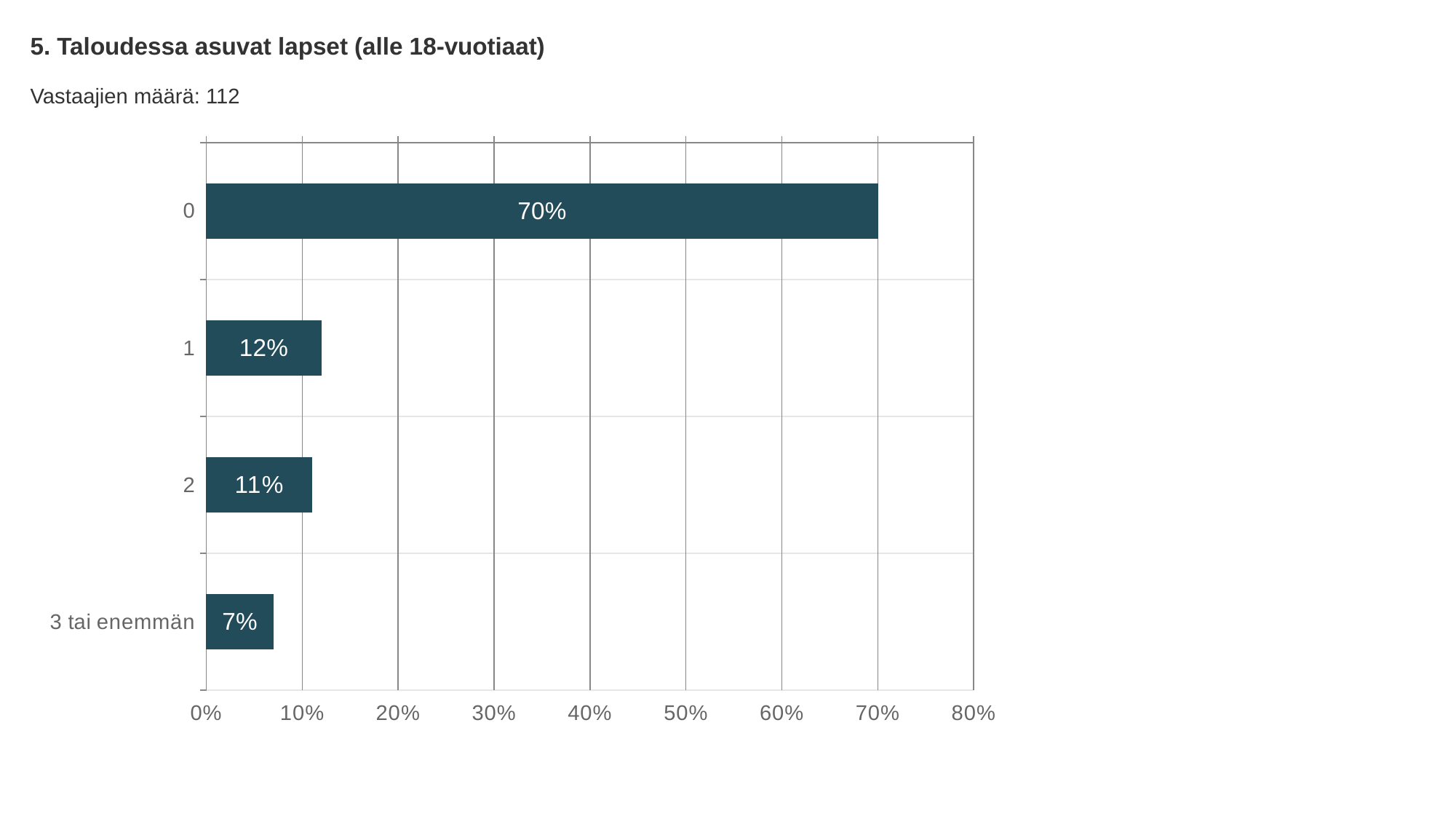
What kind of chart is shown on the slide? bar chart What is the value for the category "2"? 11% What is the difference between the values for "0" and "1"? 58% How many categories are shown in the chart? 4 Which is larger, the value for "1" or the value for "3 tai enemmän"? 1 What is the value for the category "3 tai enemmän"? 7% What is the difference between the values for "2" and "3 tai enemmän"? 4% Which category has the lowest value? 3 tai enemmän What is the title of the chart? 5. Taloudessa asuvat lapset (alle 18-vuotiaat) Which category has the highest value? 0 What is the value for the category "0"? 70% What is the value for the category "1"? 12%